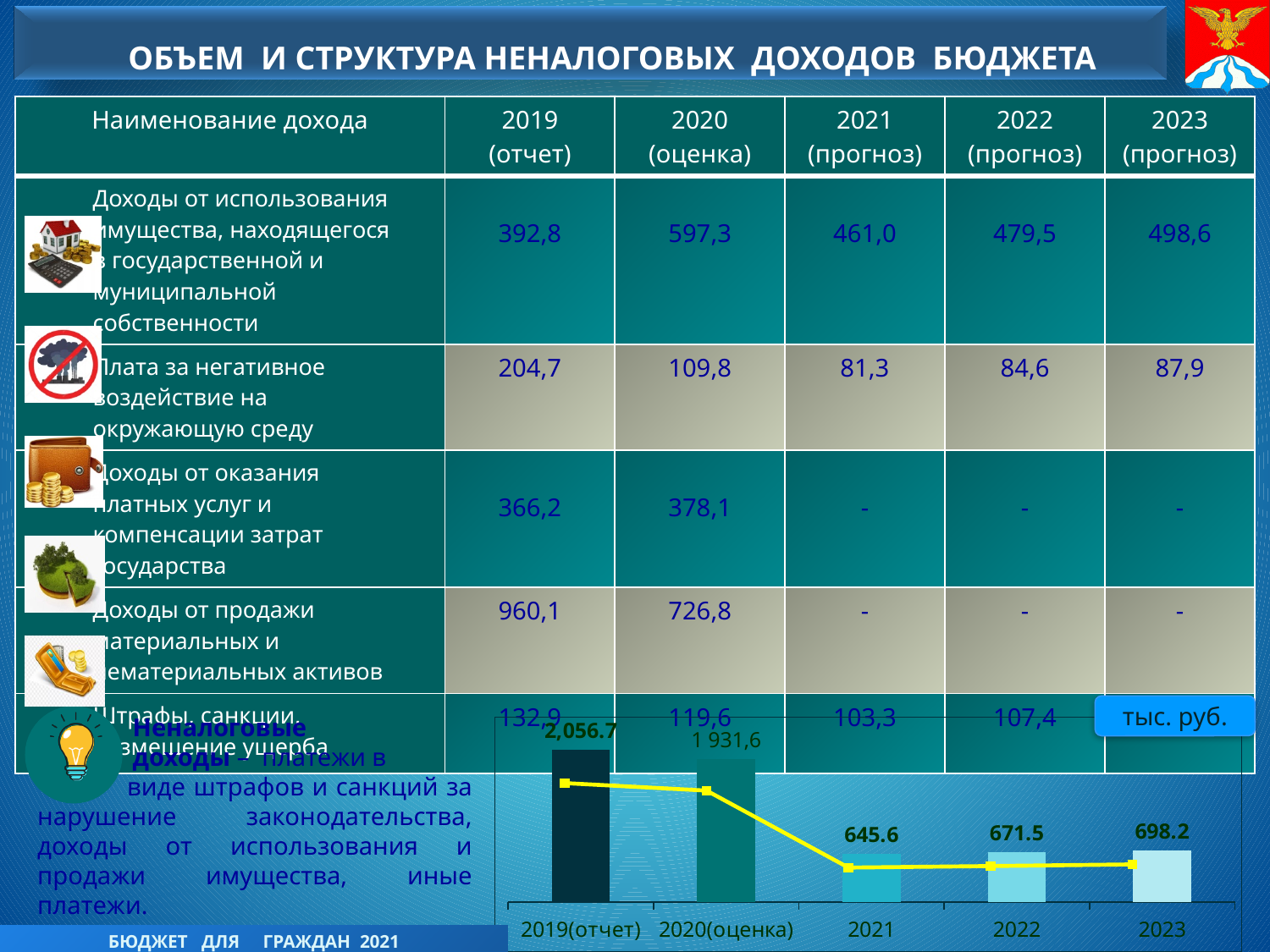
Which year has the lowest value in the chart? 2021 Do the values in the chart rise or fall from 2021 to 2023? rise What is the value shown for 2020(оценка) in the chart? 1 931,6 Which is larger in the chart, the value for 2020(оценка) or the value for 2022? 2020(оценка) How many years (categories) are plotted in the chart? 5 What is the value shown for 2023 in the chart? 698.2 What unit is indicated for the values in the chart? тыс. руб. What is the difference between the values for 2022 and 2021 in the chart? 25.9 What is the difference between the values for 2023 and 2022 in the chart? 26.7 What is the value shown for 2019(отчет) in the chart? 2,056.7 What is the value shown for 2021 in the chart at the bottom of the slide? 645.6 Which year has the highest value in the chart? 2019(отчет)